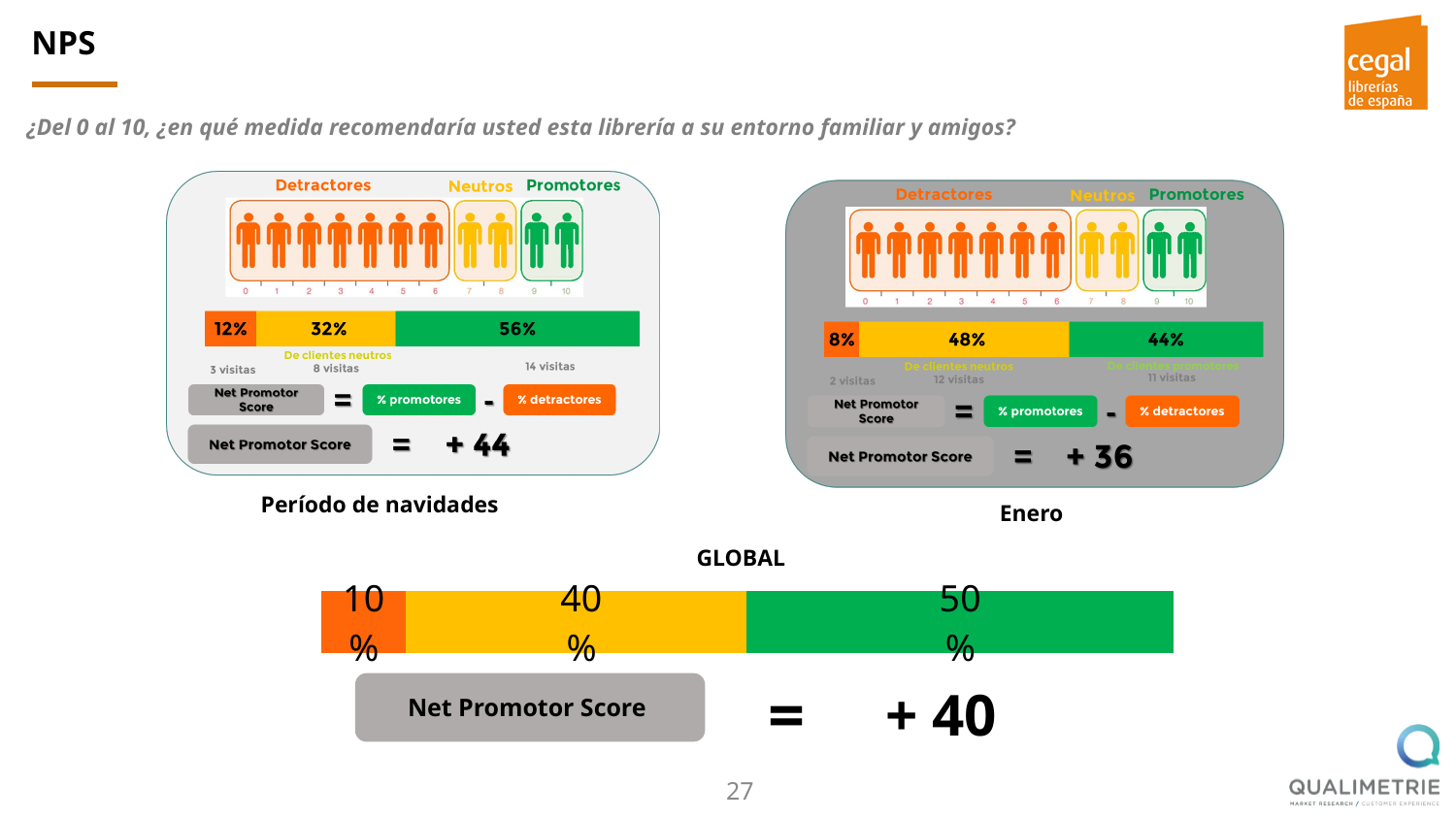
In the 'Enero' chart, what percentage of customers are Neutros? 48% In the 'Período de navidades' chart, how many visits correspond to Promotores? 14 visitas In the 'GLOBAL' chart, what percentage of customers are Promotores? 50% In the 'Enero' chart, which group has the largest share: Detractores, Neutros or Promotores? Neutros Is the Promotores share larger in the 'Período de navidades' chart or in the 'Enero' chart? Período de navidades In the 'GLOBAL' chart, what is the Net Promotor Score shown? + 40 In the 'Período de navidades' chart, what percentage of customers are Detractores? 12% In the 'Período de navidades' chart, what percentage of customers are Promotores? 56% In the 'Período de navidades' chart, which group has the smallest share? Detractores In the 'Período de navidades' chart, what is the difference between the Promotores and Detractores percentages? 44% What kind of chart is used to show the Detractores, Neutros and Promotores shares in the 'GLOBAL' section? Stacked bar chart In the 'Enero' chart, what is the Net Promotor Score shown? + 36